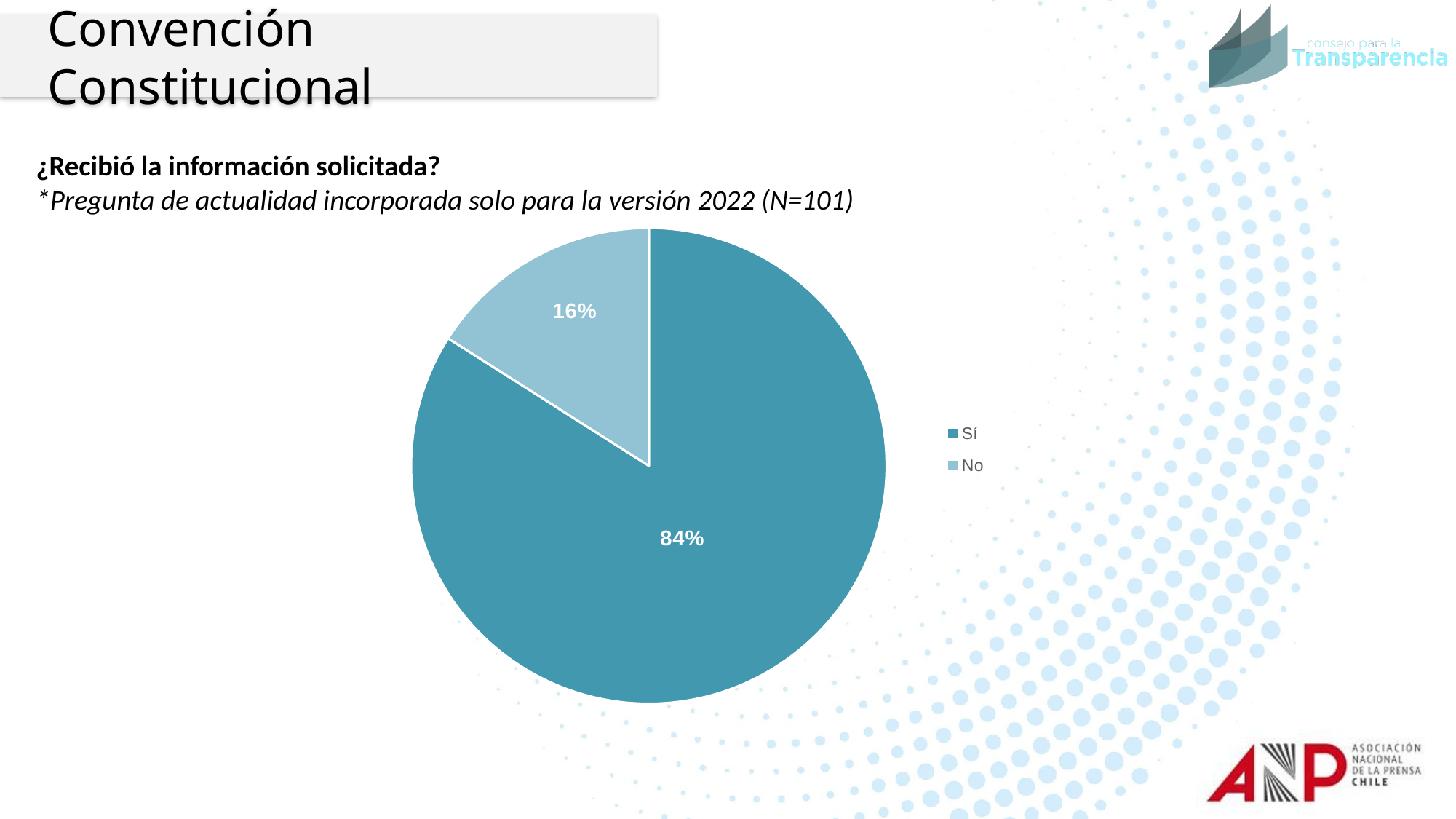
What is the difference in percentage points between the "Sí" and "No" slices? 68 How many entries does the legend list? 2 What percentage of respondents answered "Sí"? 84% How many slices does the pie chart have? 2 What question does the chart on the slide answer? ¿Recibió la información solicitada? What kind of chart is shown on the slide? Pie chart What is the sample size (N) stated for the chart? 101 Which category has the largest share of the pie? Sí Which is larger, the share for "Sí" or the share for "No"? Sí Which category has the smallest share of the pie? No What percentage of respondents answered "No"? 16% What share of the pie does the "No" slice represent? 16%